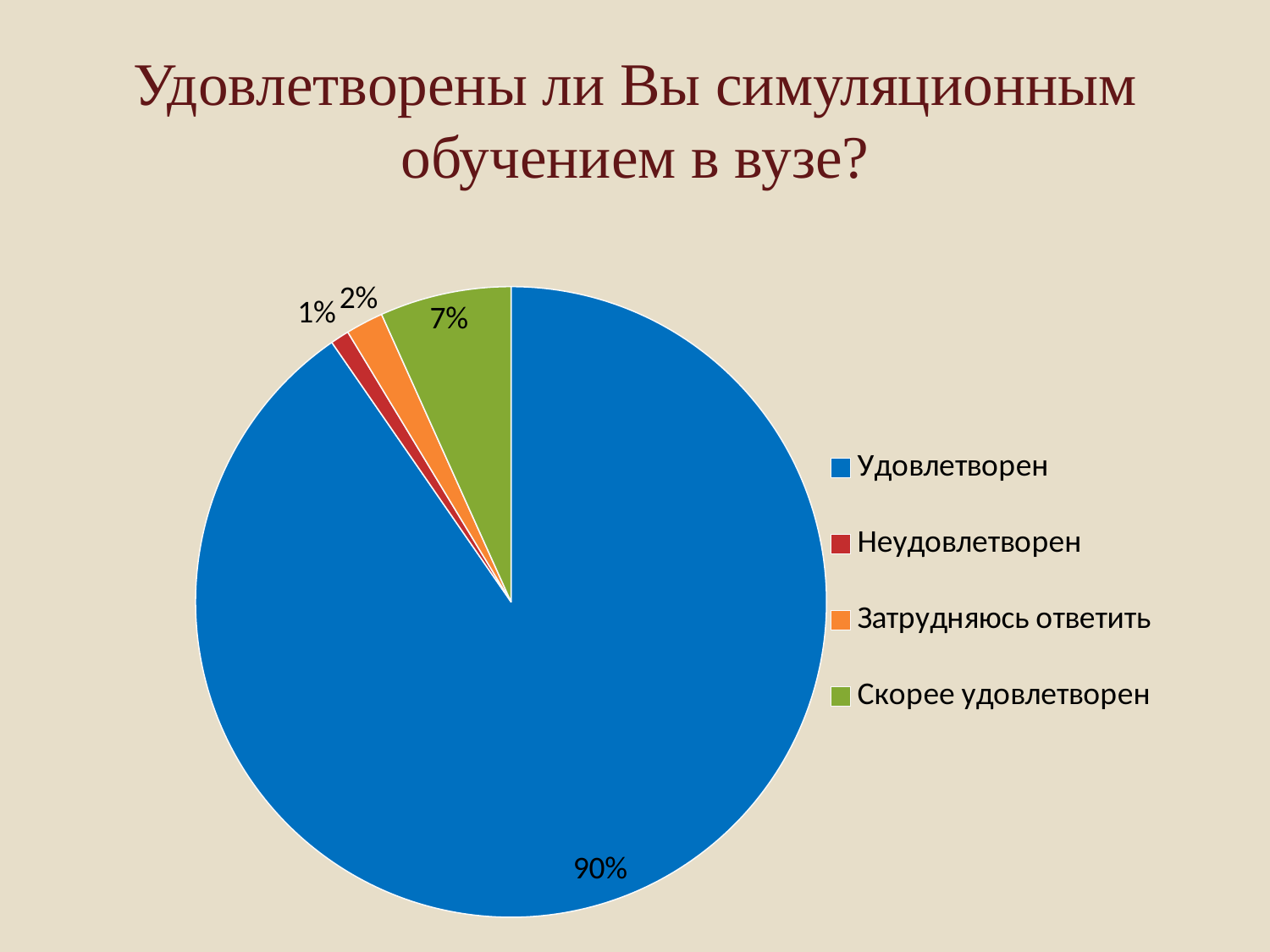
Which category has the largest slice of the pie? Удовлетворен What kind of chart is shown on the slide? pie chart How many categories does the legend list? 4 Which is larger, the share for "Скорее удовлетворен" or the share for "Затрудняюсь ответить"? Скорее удовлетворен Which category has the smallest slice of the pie? Неудовлетворен What colour is the slice for "Скорее удовлетворен"? green What share of the pie is labelled "Затрудняюсь ответить"? 2% What is the difference between the shares for "Удовлетворен" and "Скорее удовлетворен"? 83% What share of the pie is labelled "Неудовлетворен"? 1% What is the title of the chart? Удовлетворены ли Вы симуляционным обучением в вузе? What share of the pie is labelled "Скорее удовлетворен"? 7%